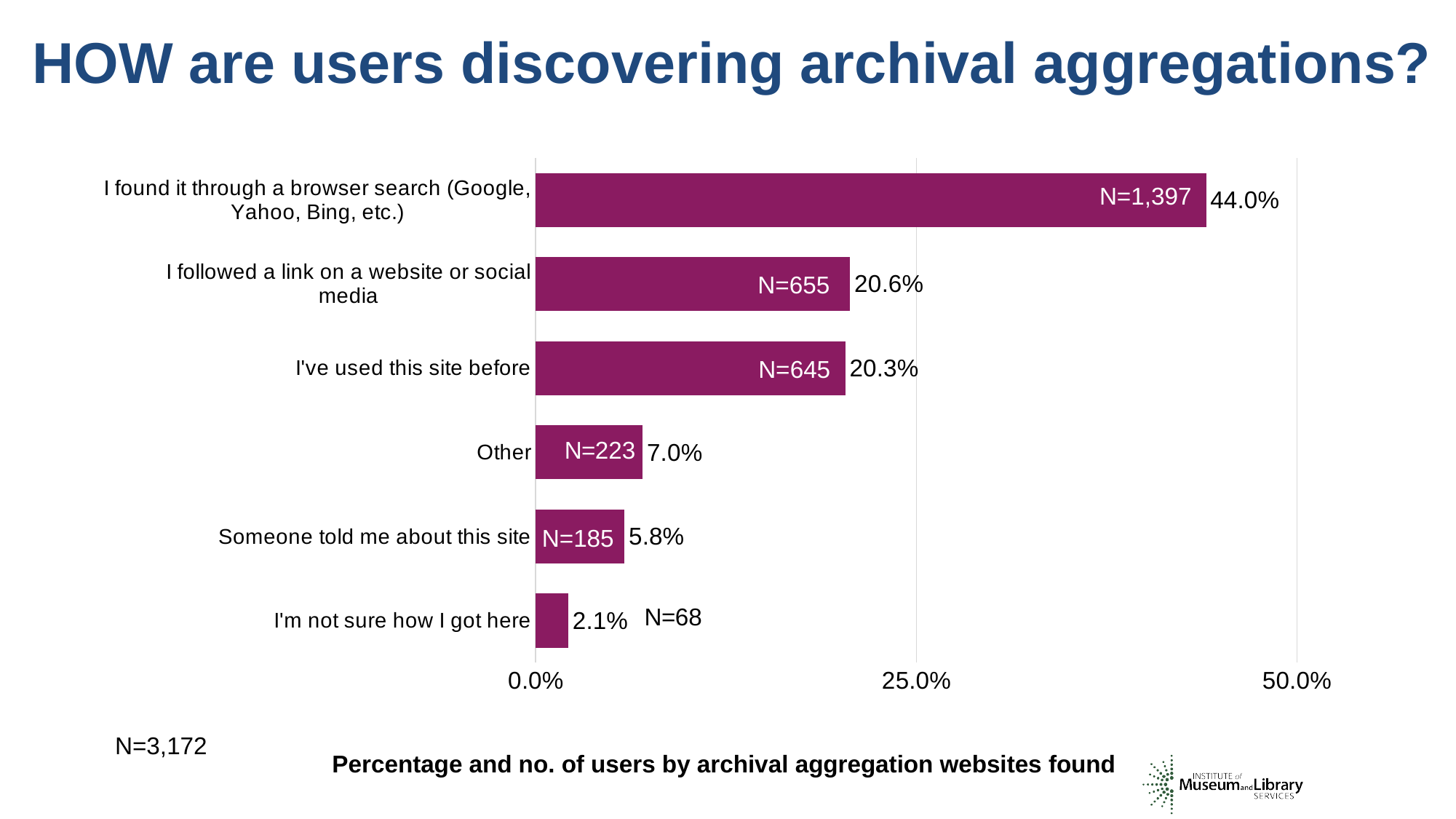
Which category has the highest percentage? I found it through a browser search (Google, Yahoo, Bing, etc.) What is the total N reported below the chart? N=3,172 Which category has the lowest percentage? I'm not sure how I got here Is the value for 'I found it through a browser search' greater or less than 25.0%? greater What kind of chart is shown on the slide? Bar chart Which is larger: the percentage for 'Other' or for 'Someone told me about this site'? Other What percentage of users said 'I've used this site before'? 20.3% What is the N value for 'I followed a link on a website or social media'? N=655 How many categories are shown in the chart? 6 What percentage of users found the site through a browser search (Google, Yahoo, Bing, etc.)? 44.0% What is the difference in percentage points between 'I found it through a browser search' and 'I followed a link on a website or social media'? 23.4 What percentage of users chose 'Someone told me about this site'? 5.8%